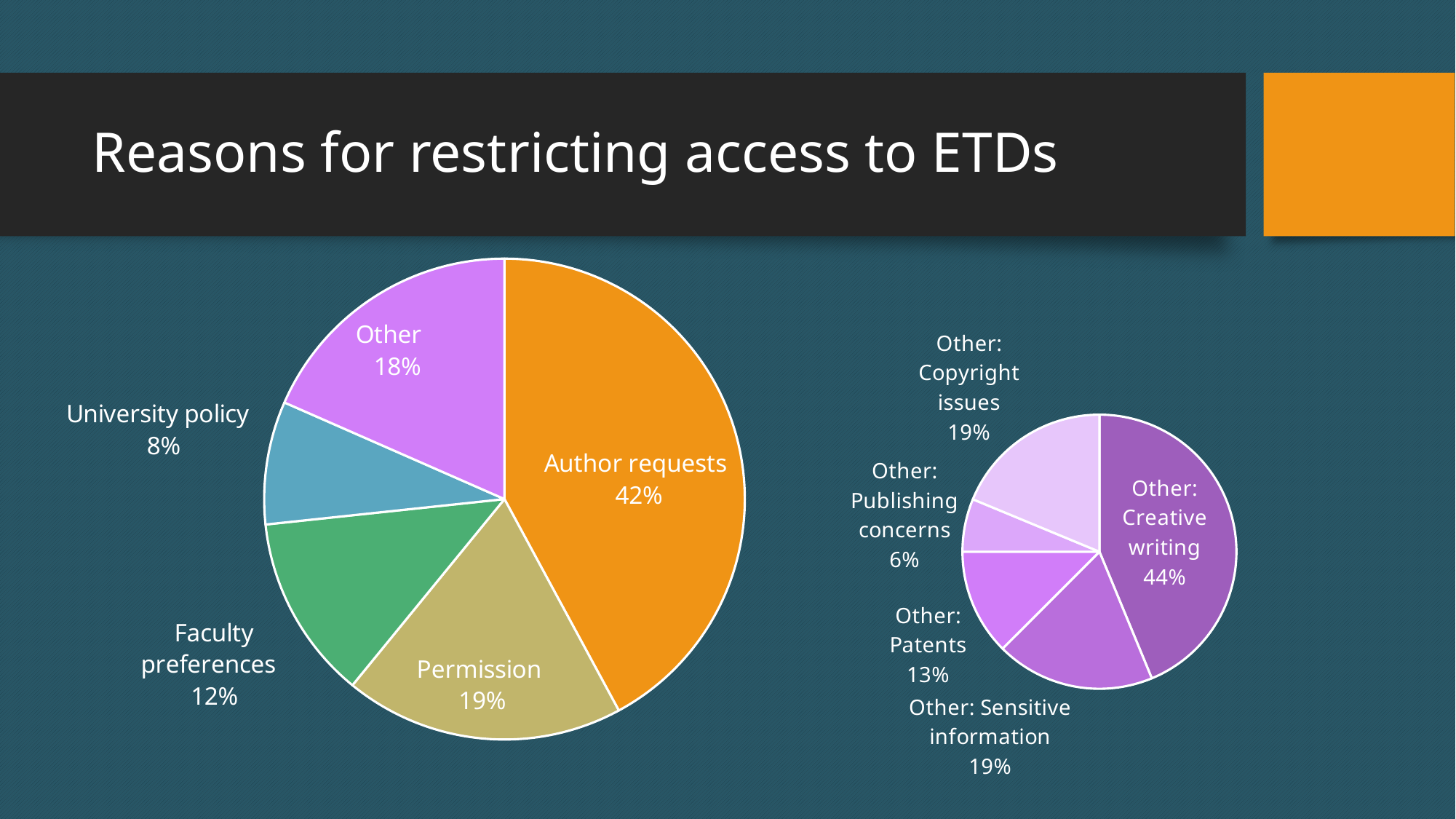
On the left pie chart, which is larger: Other or Faculty preferences? Other On the left pie chart, what share is labelled for Faculty preferences? 12% On the left pie chart, what share is labelled for Author requests? 42% On the right pie chart, what is the difference in percentage points between Other: Creative writing and Other: Patents? 31 How many slices does the left pie chart have? 5 On the right pie chart, which category has the smallest slice? Other: Publishing concerns On the right pie chart, what share is labelled for Other: Creative writing? 44% On the left pie chart, which category has the largest slice? Author requests What type of chart is shown on the slide? Pie chart On the right pie chart, what share is labelled for Other: Publishing concerns? 6% On the left pie chart, what is the difference in percentage points between Author requests and Permission? 23 On the left pie chart, which category has the smallest slice? University policy